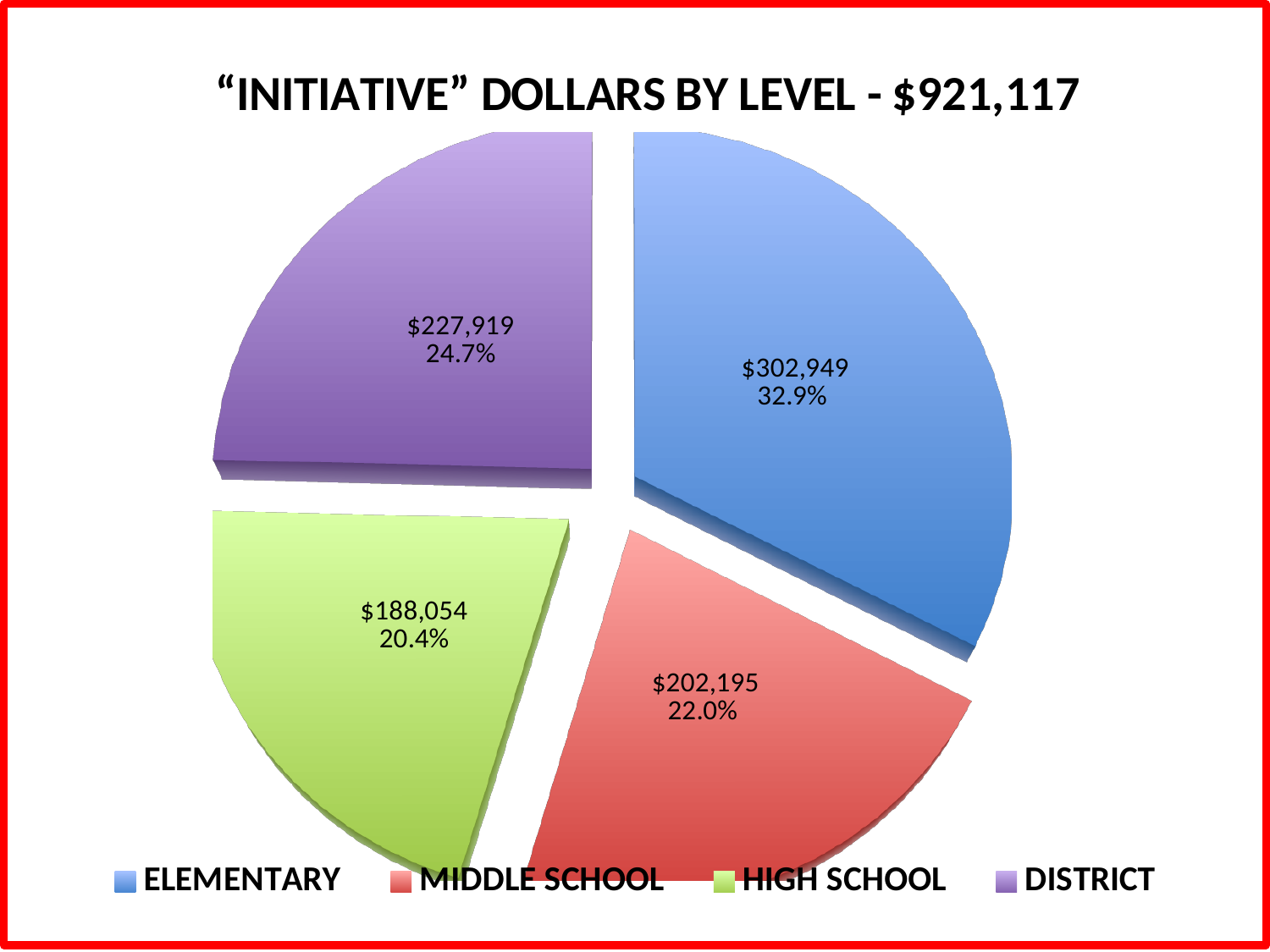
How many slices does the pie chart have? 4 Which level has the smallest share of initiative dollars? HIGH SCHOOL What is the dollar value for ELEMENTARY? $302,949 What share of the pie does DISTRICT represent? 24.7% What is the difference in dollars between ELEMENTARY and MIDDLE SCHOOL? $100,754 What is the dollar value for DISTRICT? $227,919 Which level has the largest share of initiative dollars? ELEMENTARY What is the dollar value for HIGH SCHOOL? $188,054 What is the dollar value for MIDDLE SCHOOL? $202,195 What share of the pie does HIGH SCHOOL represent? 20.4% What kind of chart is shown on the slide? pie chart Which is larger, the value for DISTRICT or the value for MIDDLE SCHOOL? DISTRICT